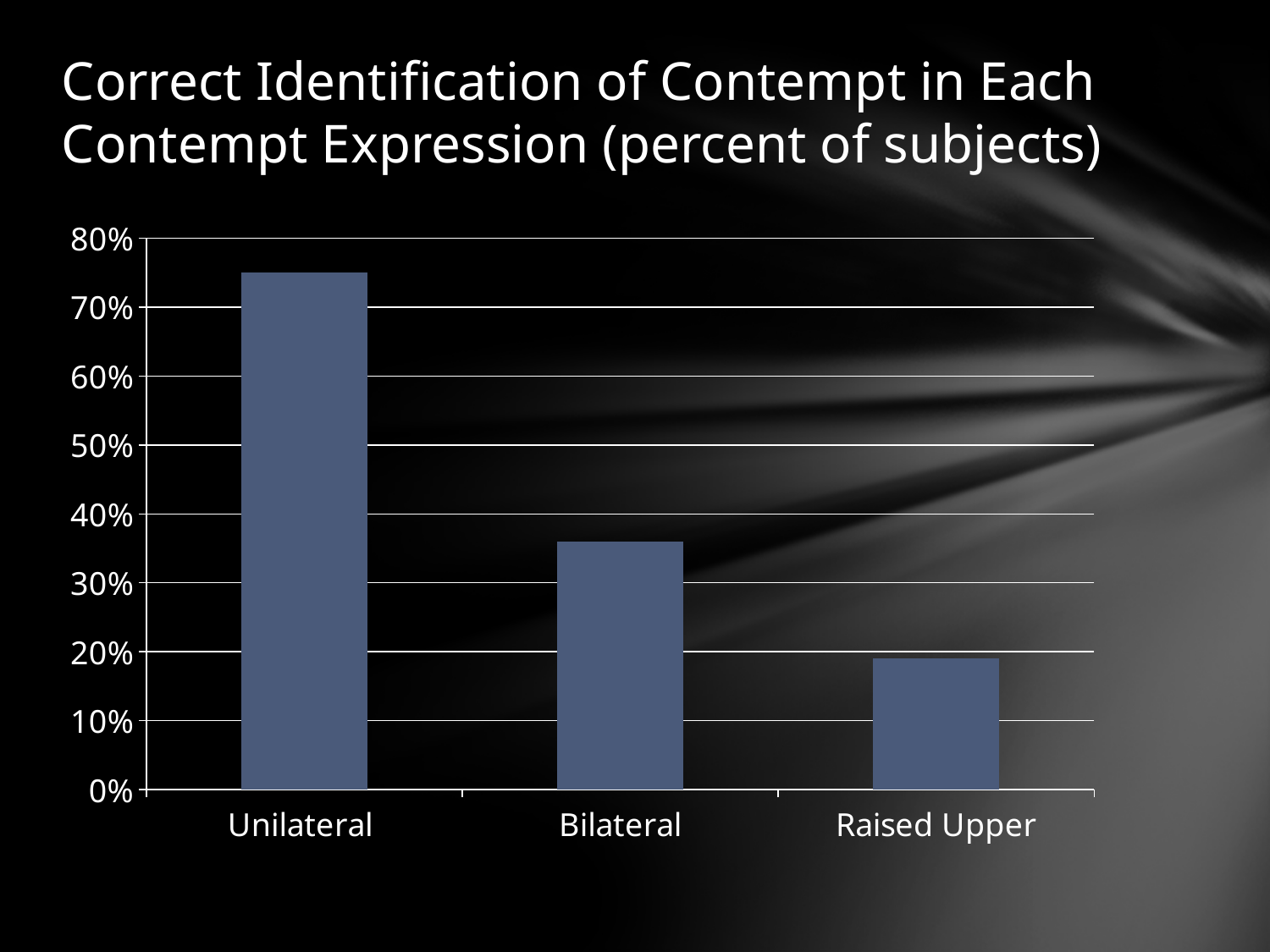
Is the value for Unilateral greater or less than 70%? greater Which contempt expression has the lowest percentage of correct identification? Raised Upper Is the value for Bilateral greater or less than 30%? greater Which has a higher value, Bilateral or Raised Upper? Bilateral Do the values rise or fall from left to right across the categories? fall What is the title of the chart? Correct Identification of Contempt in Each Contempt Expression (percent of subjects) Is the value for Bilateral greater or less than 40%? less How many categories are shown on the x axis? 3 Which has a higher value, Unilateral or Bilateral? Unilateral What kind of chart is shown on the slide? bar chart Which contempt expression has the highest percentage of correct identification? Unilateral